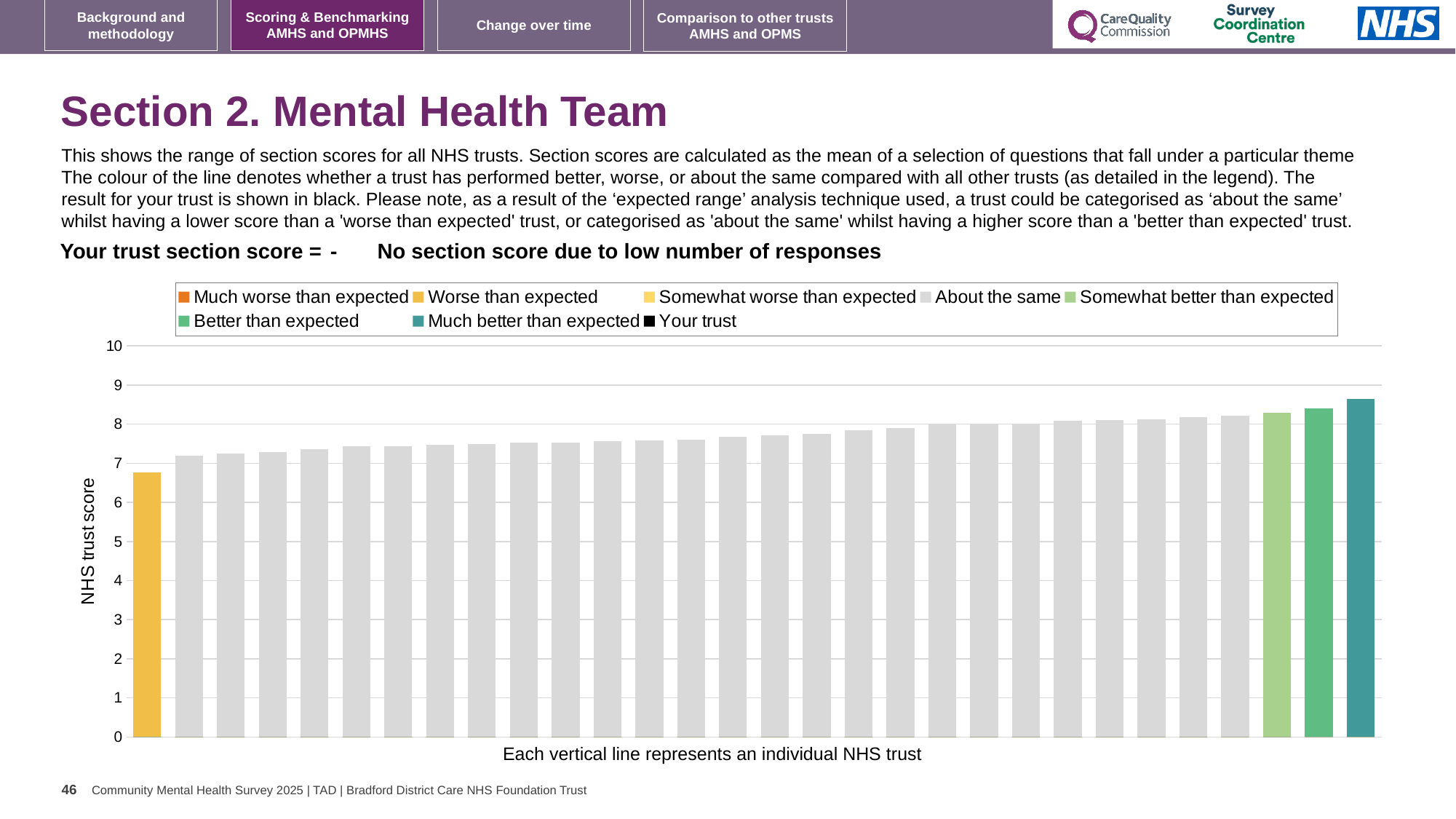
How many bars are coloured as 'Much better than expected'? 1 What kind of chart is shown on the slide? Bar chart Do the bar values rise or fall from left to right across the chart? Rise Is the value of the leftmost (yellow) bar greater or less than 7? less How many entries does the chart legend list? 8 Which is larger, the leftmost bar or the rightmost bar? The rightmost bar Is the value of the rightmost bar greater or less than 9? less Which legend category does the highest bar belong to? Much better than expected Is the value of the rightmost (teal) bar greater or less than 8? greater Which legend category does the lowest bar belong to? Worse than expected What is the label on the vertical axis of the chart? NHS trust score